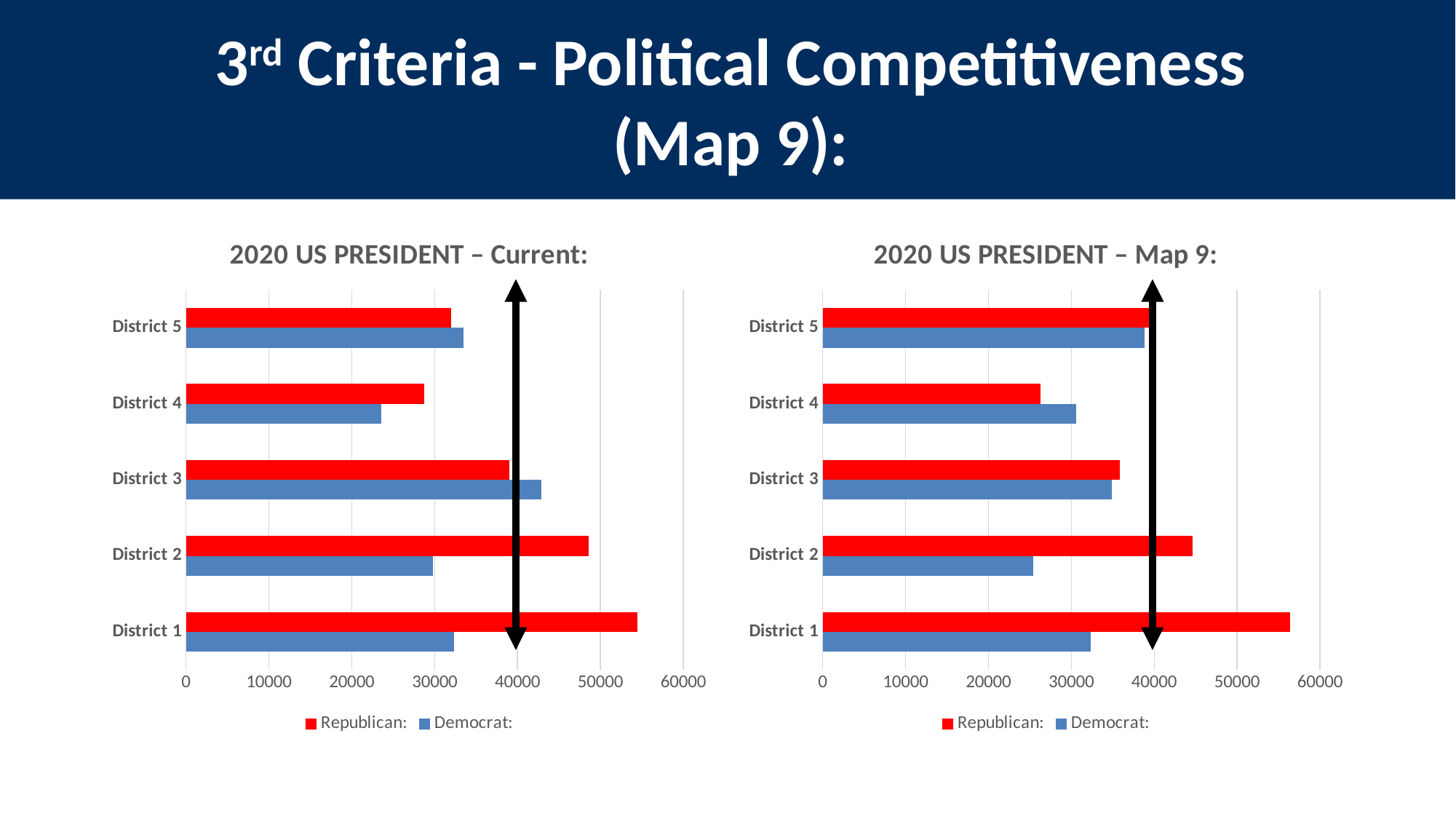
In the chart titled '2020 US PRESIDENT – Map 9:', which district has the highest Republican value? District 1 In the chart titled '2020 US PRESIDENT – Current:', is the Democrat value for District 4 greater or less than 30000? less How many series does the legend of the chart titled '2020 US PRESIDENT – Map 9:' list? 2 In the chart titled '2020 US PRESIDENT – Current:', which district has the lowest Democrat value? District 4 In the chart titled '2020 US PRESIDENT – Map 9:', for District 2, which is larger: the Republican value or the Democrat value? Republican In the chart titled '2020 US PRESIDENT – Map 9:', is the Democrat value for District 2 greater or less than 30000? less In the chart titled '2020 US PRESIDENT – Current:', is the Republican value for District 2 greater or less than 40000? greater In the chart titled '2020 US PRESIDENT – Current:', for District 3, which is larger: the Republican value or the Democrat value? Democrat In the chart titled '2020 US PRESIDENT – Map 9:', which district has the lowest Republican value? District 4 In the chart titled '2020 US PRESIDENT – Current:', which district has the highest Republican value? District 1 How many districts are shown in the chart titled '2020 US PRESIDENT – Current:'? 5